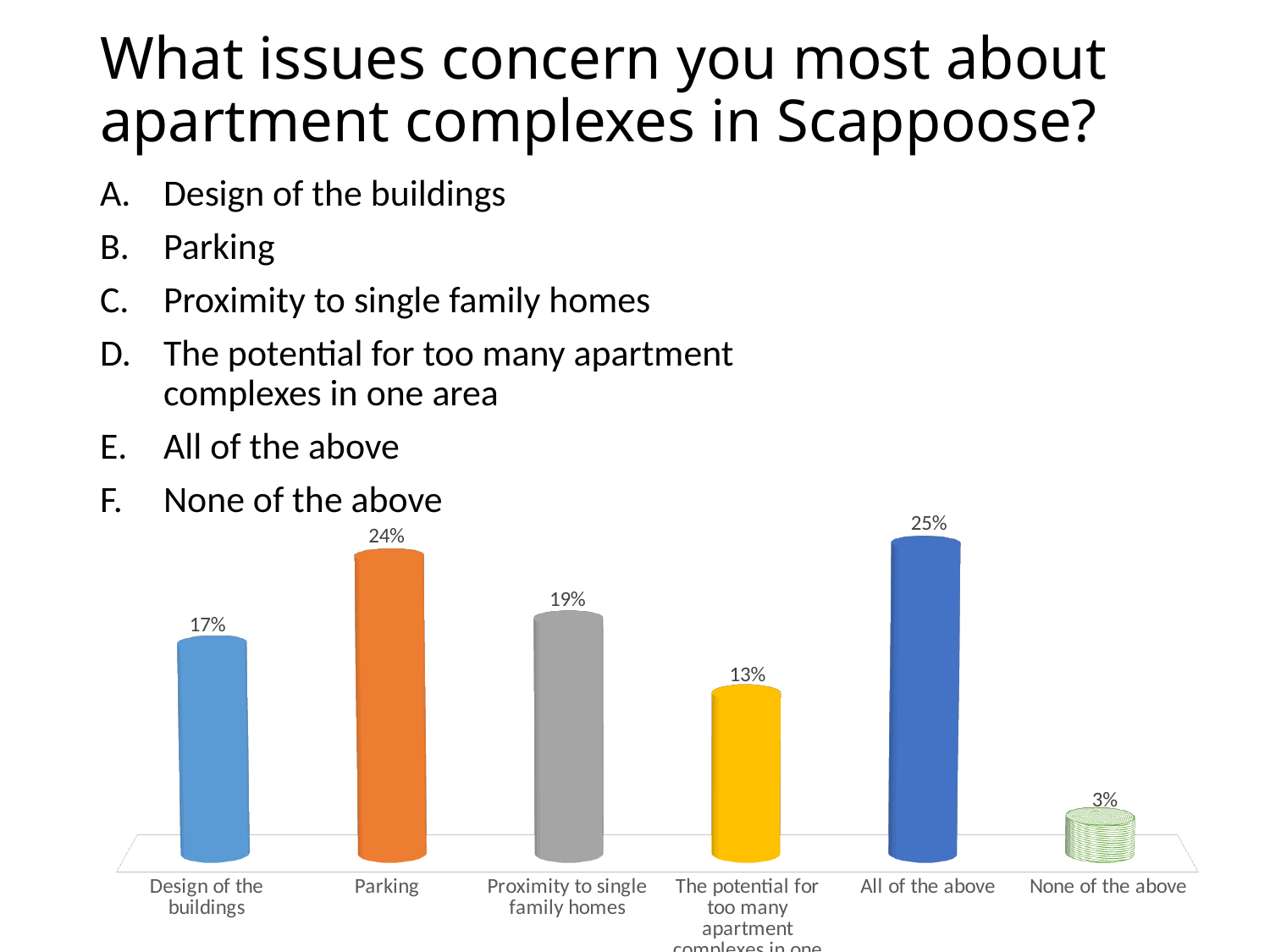
What is the difference between the values for All of the above and Parking? 1% Which is larger, the value for Proximity to single family homes or the value for The potential for too many apartment complexes in one area? Proximity to single family homes What colour is the bar for Parking? Orange What is the value for Design of the buildings? 17% What percentage is shown for Proximity to single family homes? 19% Which category has the lowest value? None of the above What is the difference between the values for Parking and Design of the buildings? 7% What is the value for None of the above? 3% How many categories are shown in the chart? 6 What percentage of respondents chose Parking? 24% Which category has the highest value? All of the above What kind of chart is shown on the slide? Bar chart